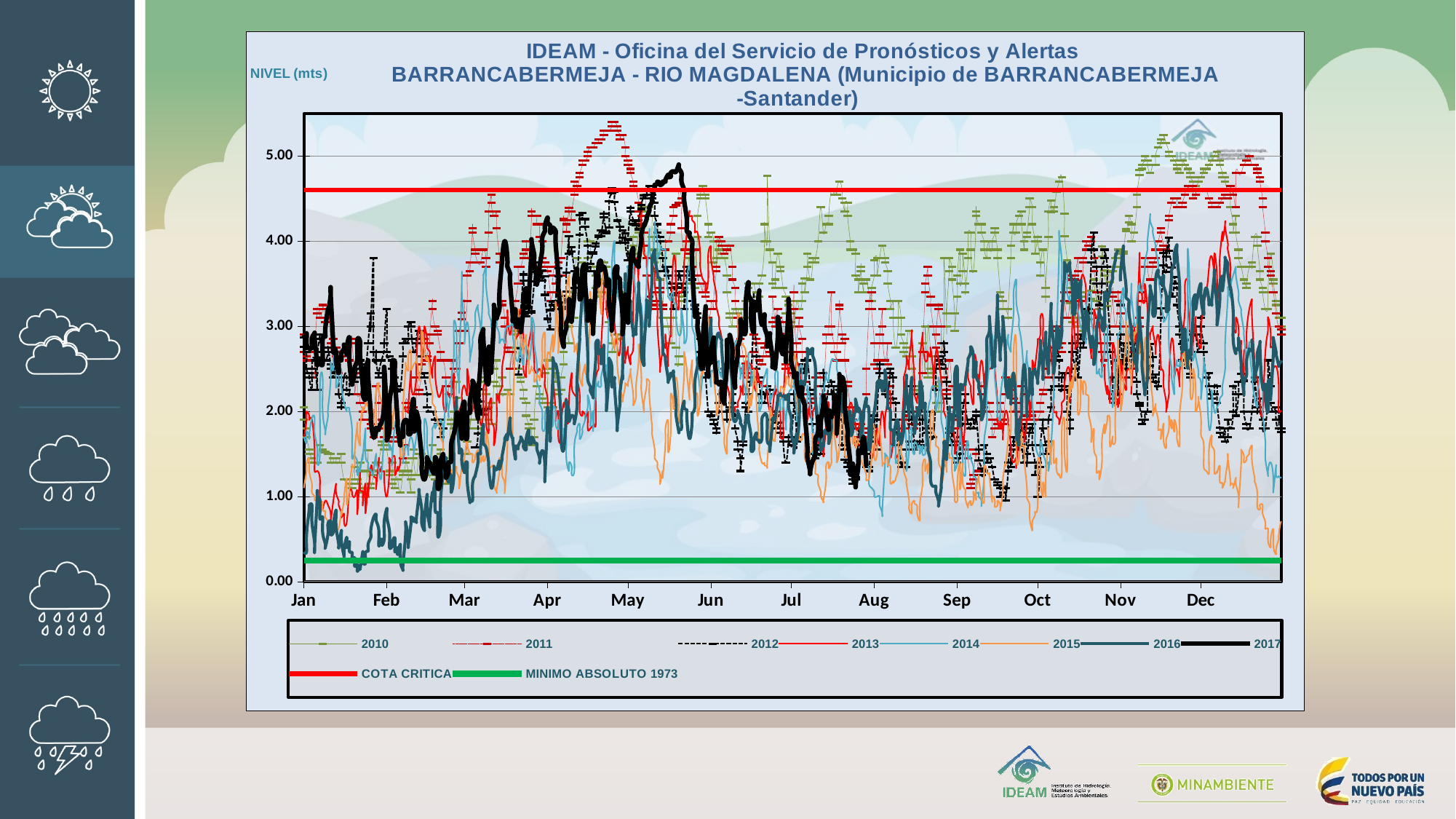
What is the label of the y axis? NIVEL (mts) Which is higher on the chart, the COTA CRITICA line or the MINIMO ABSOLUTO 1973 line? COTA CRITICA How many series does the legend list? 10 What kind of chart is shown on the slide? line chart Which series reaches the highest level on the chart? 2011 Is the COTA CRITICA line greater or less than 4.00? greater Is the highest value of the 2011 series, reached in May, greater or less than 5.00? greater How many months are labelled along the x axis? 12 Is the peak of the 2017 series in May greater or less than 4.00? greater What colour is the COTA CRITICA line in the legend? red